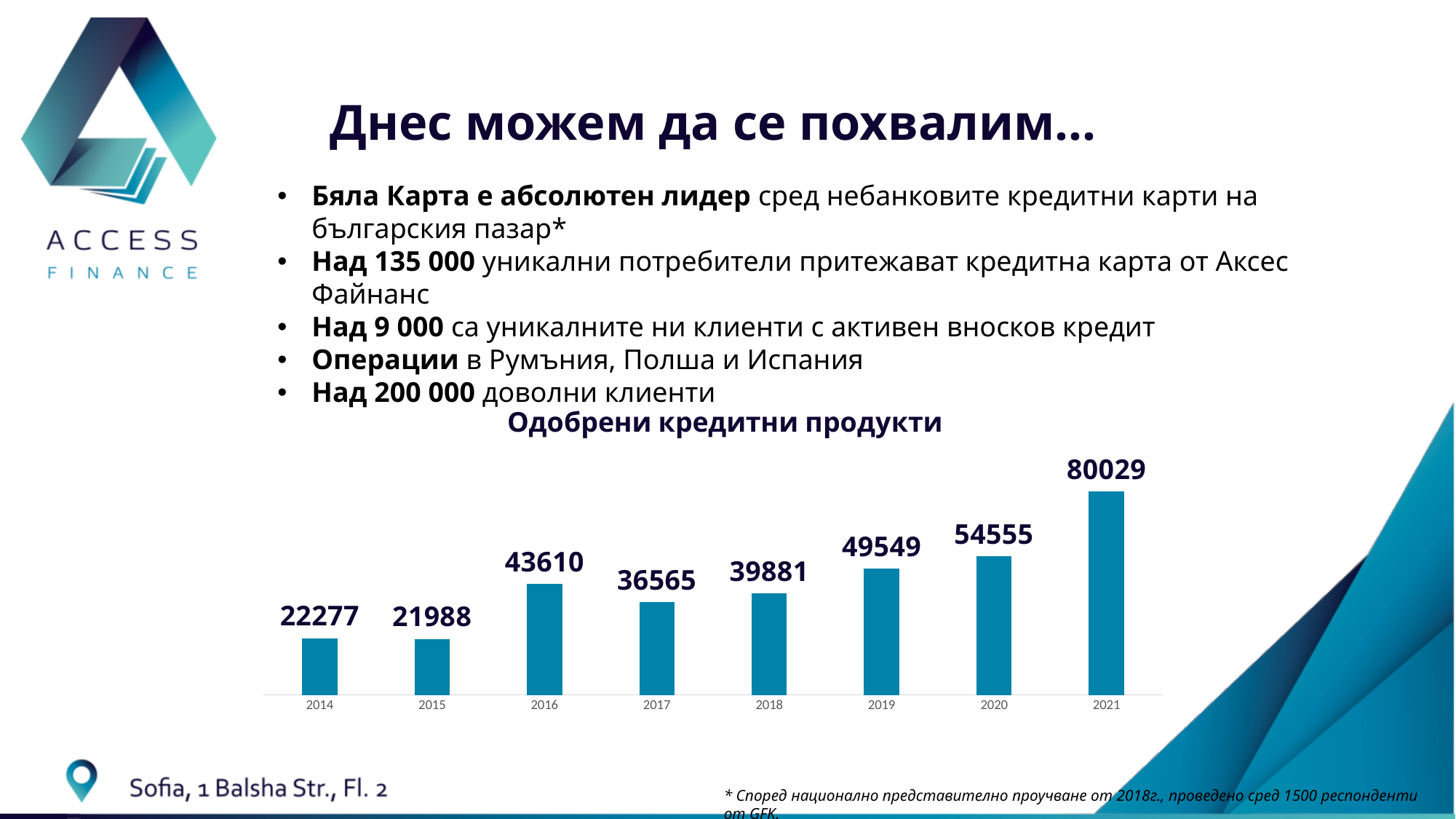
Which year has the lowest value in the chart? 2015 What is the value for 2021 in the chart? 80029 What kind of chart is shown on the slide? bar chart How many years are shown in the chart? 8 What is the difference between the values for 2021 and 2020? 25474 What is the title of the chart? Одобрени кредитни продукти What is the value for 2014 in the chart? 22277 Do the values generally rise or fall from 2017 to 2021? rise Which is larger, the value for 2016 or the value for 2018? 2016 Which year has the highest value in the chart? 2021 What is the value for 2018 in the chart? 39881 What is the difference between the values for 2016 and 2017? 7045